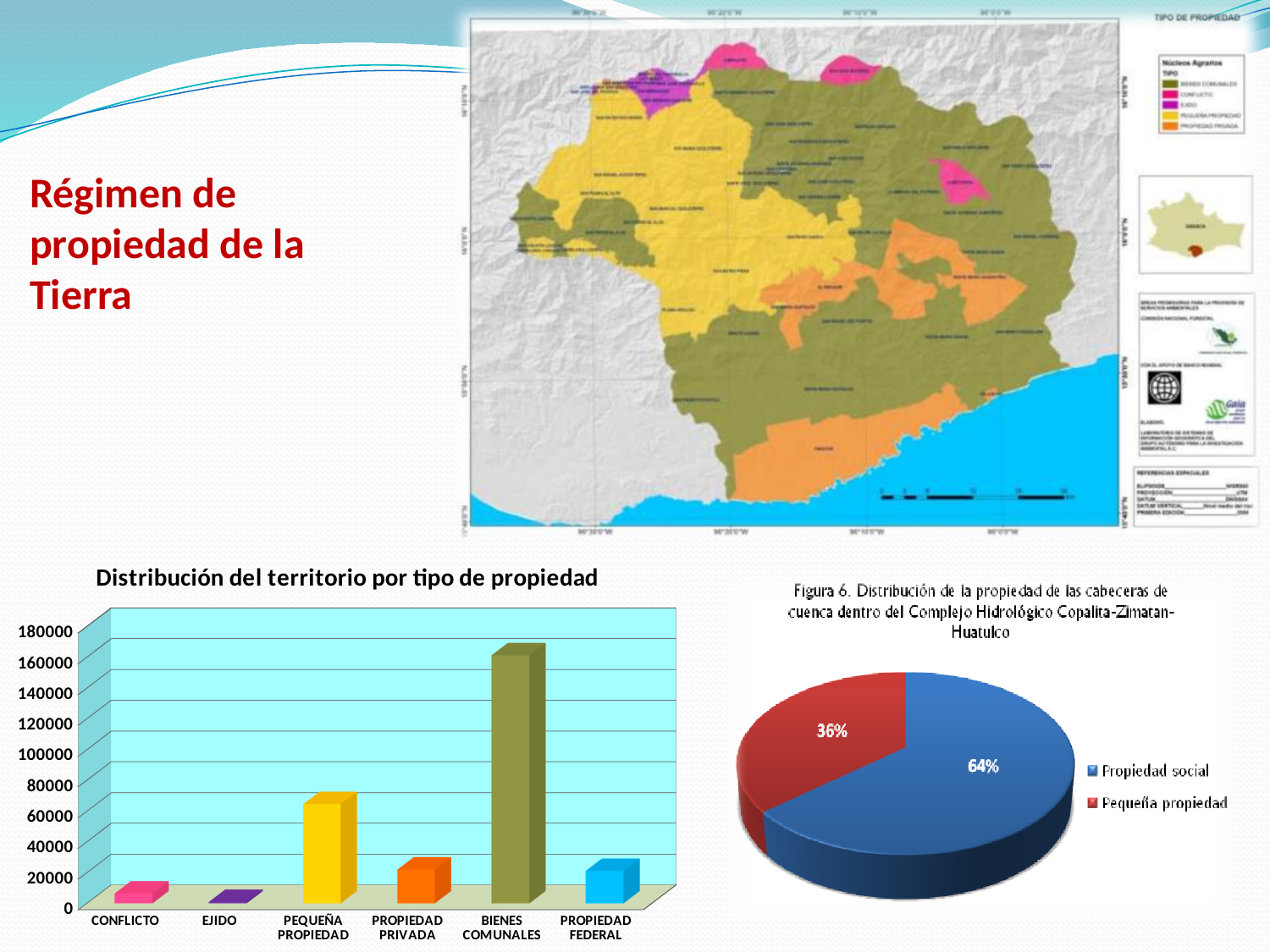
In the bar chart 'Distribución del territorio por tipo de propiedad', is the value for BIENES COMUNALES greater or less than 140000? greater In the pie chart 'Figura 6', what share is Pequeña propiedad? 36% In the bar chart 'Distribución del territorio por tipo de propiedad', which category has the lowest value? EJIDO In the bar chart 'Distribución del territorio por tipo de propiedad', which category has the highest value? BIENES COMUNALES What kind of chart is 'Distribución del territorio por tipo de propiedad'? Bar chart How many categories are shown in the bar chart 'Distribución del territorio por tipo de propiedad'? 6 In the bar chart 'Distribución del territorio por tipo de propiedad', is the value for PEQUEÑA PROPIEDAD greater or less than 80000? less In the bar chart 'Distribución del territorio por tipo de propiedad', which is larger: PEQUEÑA PROPIEDAD or PROPIEDAD PRIVADA? PEQUEÑA PROPIEDAD In the pie chart 'Figura 6', what share is Propiedad social? 64% In the bar chart 'Distribución del territorio por tipo de propiedad', is the value for PROPIEDAD PRIVADA greater or less than 40000? less In the pie chart 'Figura 6', how many entries does the legend list? 2 In the pie chart 'Figura 6', what is the difference in percentage points between Propiedad social and Pequeña propiedad? 28